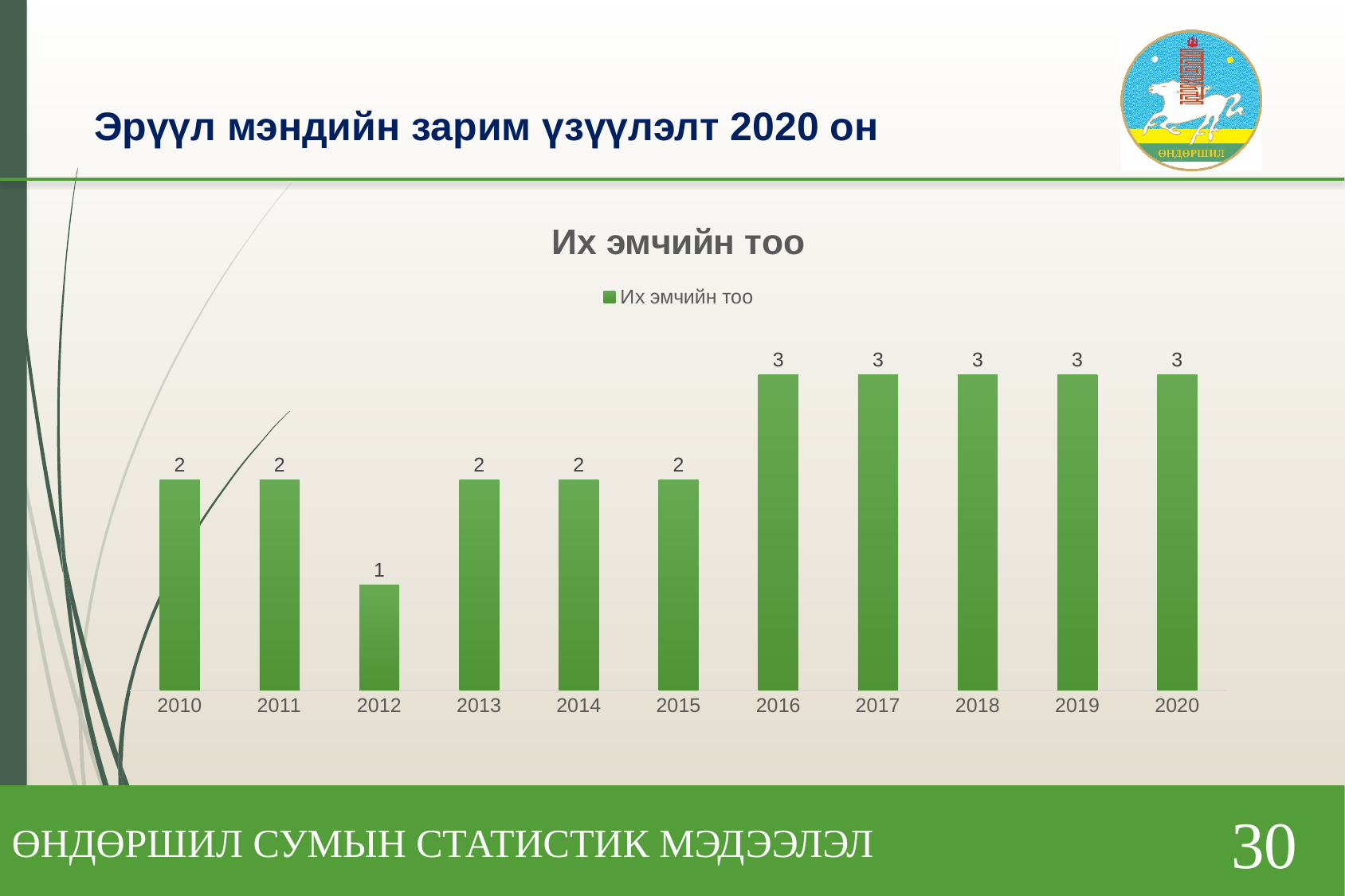
Do the values rise or fall from 2015 to 2016? rise Which year has the lowest value? 2012 What is the difference between the values for 2020 and 2012? 2 What is the value for 2016? 3 How many series does the legend list? 1 What is the title of the chart? Их эмчийн тоо Which is larger, the value for 2015 or the value for 2016? 2016 What colour are the bars? green What is the value for 2010? 2 How many years are shown on the x axis? 11 What is the value for 2012? 1 What kind of chart is shown? bar chart